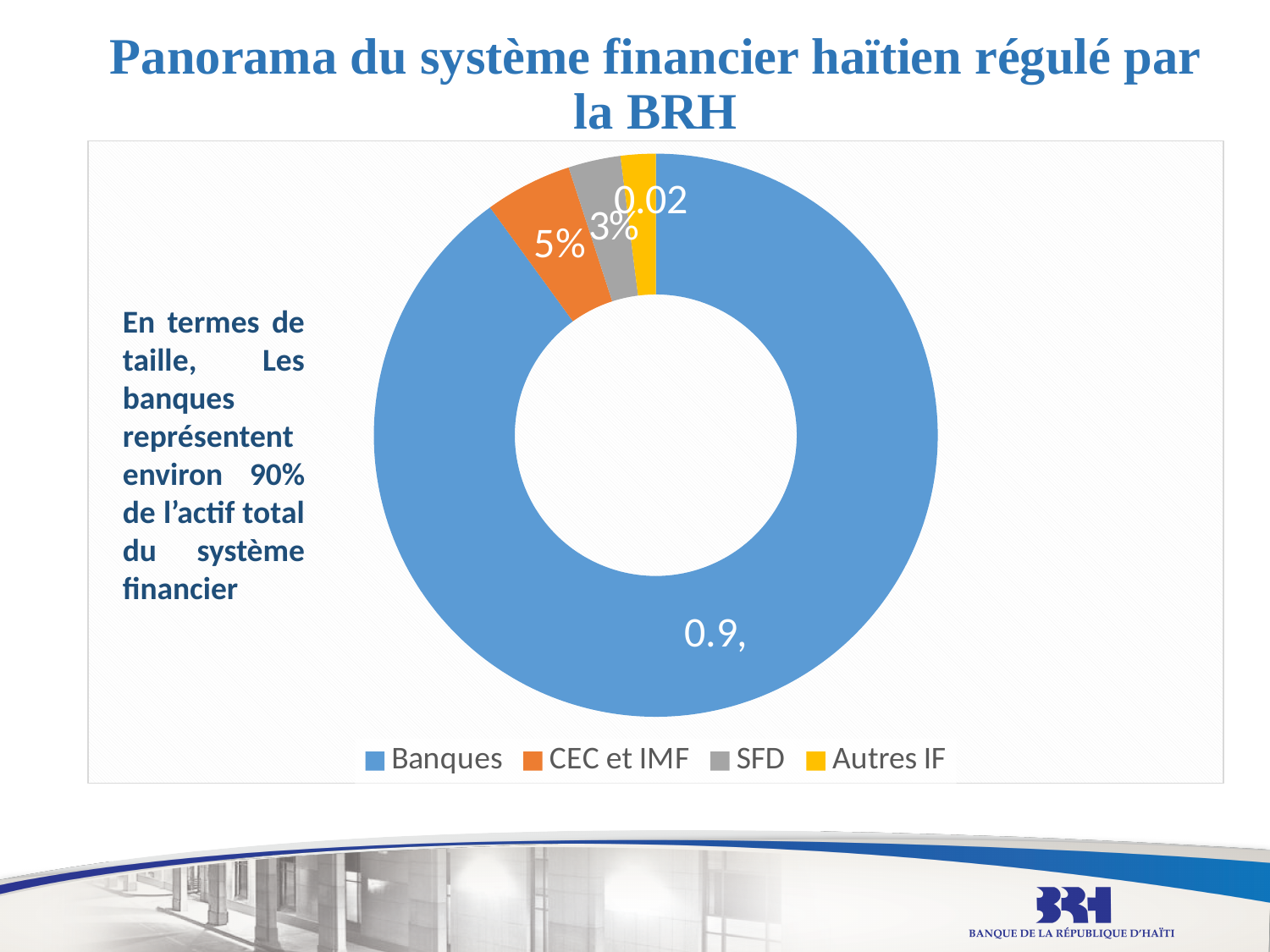
What are the entries listed in the chart legend? Banques, CEC et IMF, SFD, Autres IF What is the difference between the CEC et IMF value and the SFD value? 2% What value is shown for the SFD slice? 3% Which slice is larger, CEC et IMF or SFD? CEC et IMF Which category has the largest slice of the chart? Banques Which category has the smallest slice of the chart? Autres IF What colour is the Banques slice? Blue What value is shown for the CEC et IMF slice? 5% What value is shown for the Autres IF slice? 0.02 What kind of chart is shown on the slide? Doughnut chart How many categories are shown in the chart? 4 What value is shown for the Banques slice? 0.9